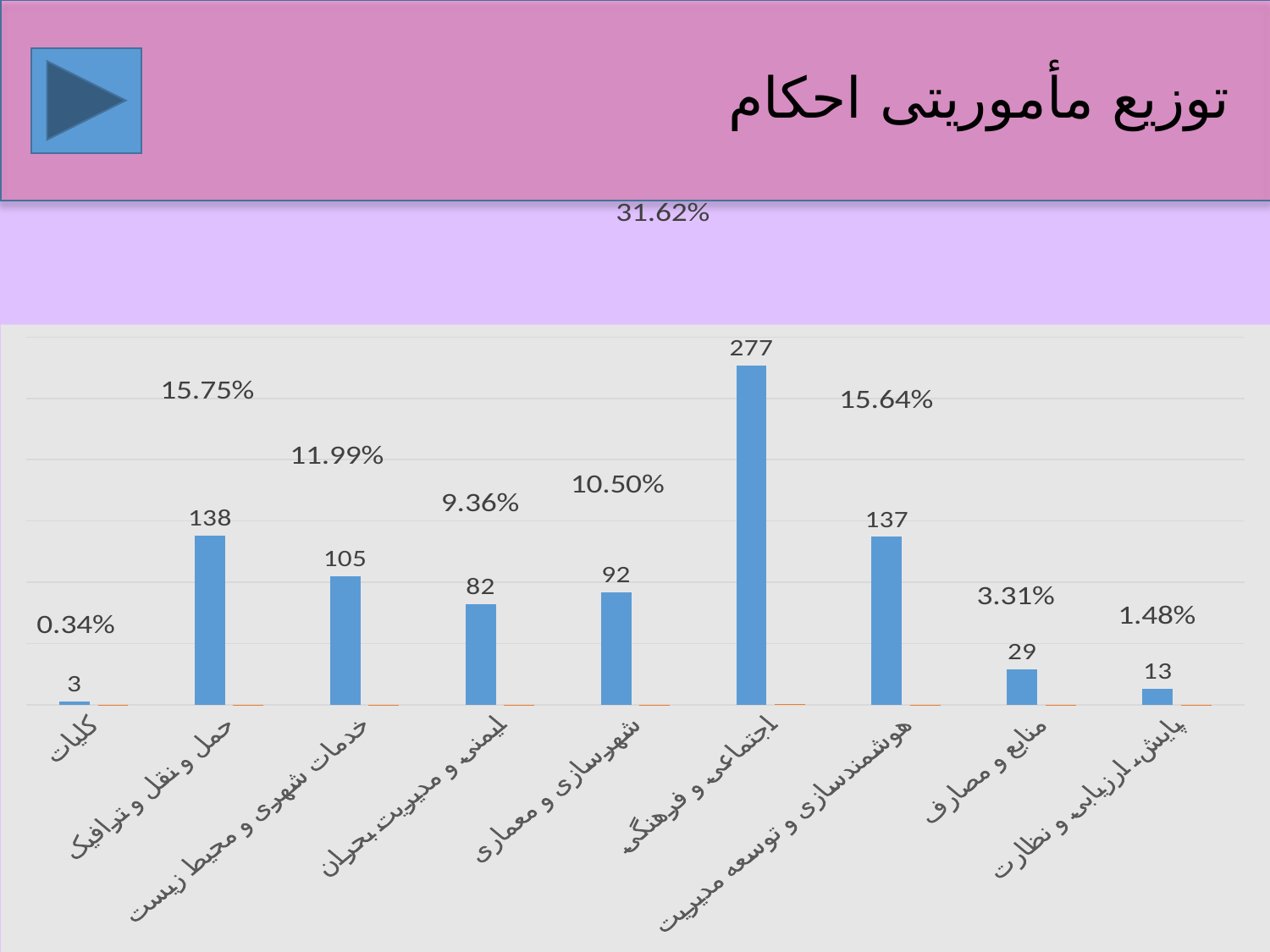
What kind of chart is shown on the slide? bar chart Which category has the highest value? اجتماعی و فرهنگی What percentage label is shown above the bar for خدمات شهری و محیط زیست? 11.99% What is the difference between the values for حمل و نقل و ترافیک and ایمنی و مدیریت بحران? 56 What is the difference between the values for اجتماعی و فرهنگی and هوشمندسازی و توسعه مدیریت? 140 What is the value shown for حمل و نقل و ترافیک? 138 What is the value shown for اجتماعی و فرهنگی? 277 What is the title of the slide? توزیع مأموریتی احکام How many categories are shown on the x axis? 9 What percentage label is shown for منابع و مصارف? 3.31% Which is larger, the value for شهرسازی و معماری or the value for ایمنی و مدیریت بحران? شهرسازی و معماری Which category has the lowest value? کلیات